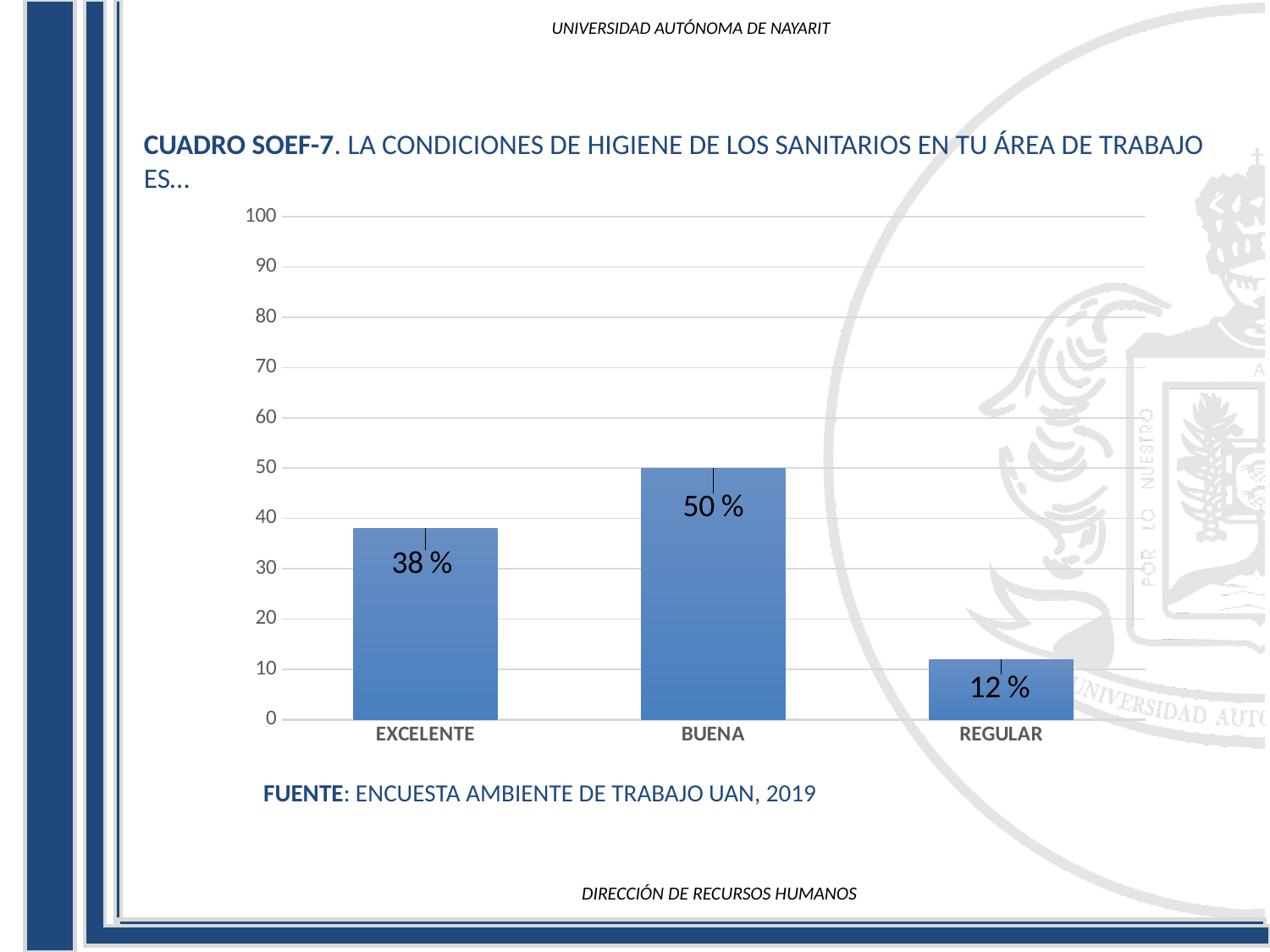
What kind of chart is shown on the slide? bar chart What is the value for BUENA? 50 % Which is larger, the value for EXCELENTE or the value for REGULAR? EXCELENTE What is the value for REGULAR? 12 % What is the value for EXCELENTE? 38 % Which category has the lowest value? REGULAR What is the difference between the values for BUENA and EXCELENTE? 12 % How many categories are shown on the x axis? 3 Which category has the highest value? BUENA What is the source cited below the chart? ENCUESTA AMBIENTE DE TRABAJO UAN, 2019 Is the value for EXCELENTE greater or less than 40? less What is the difference between the values for EXCELENTE and REGULAR? 26 %